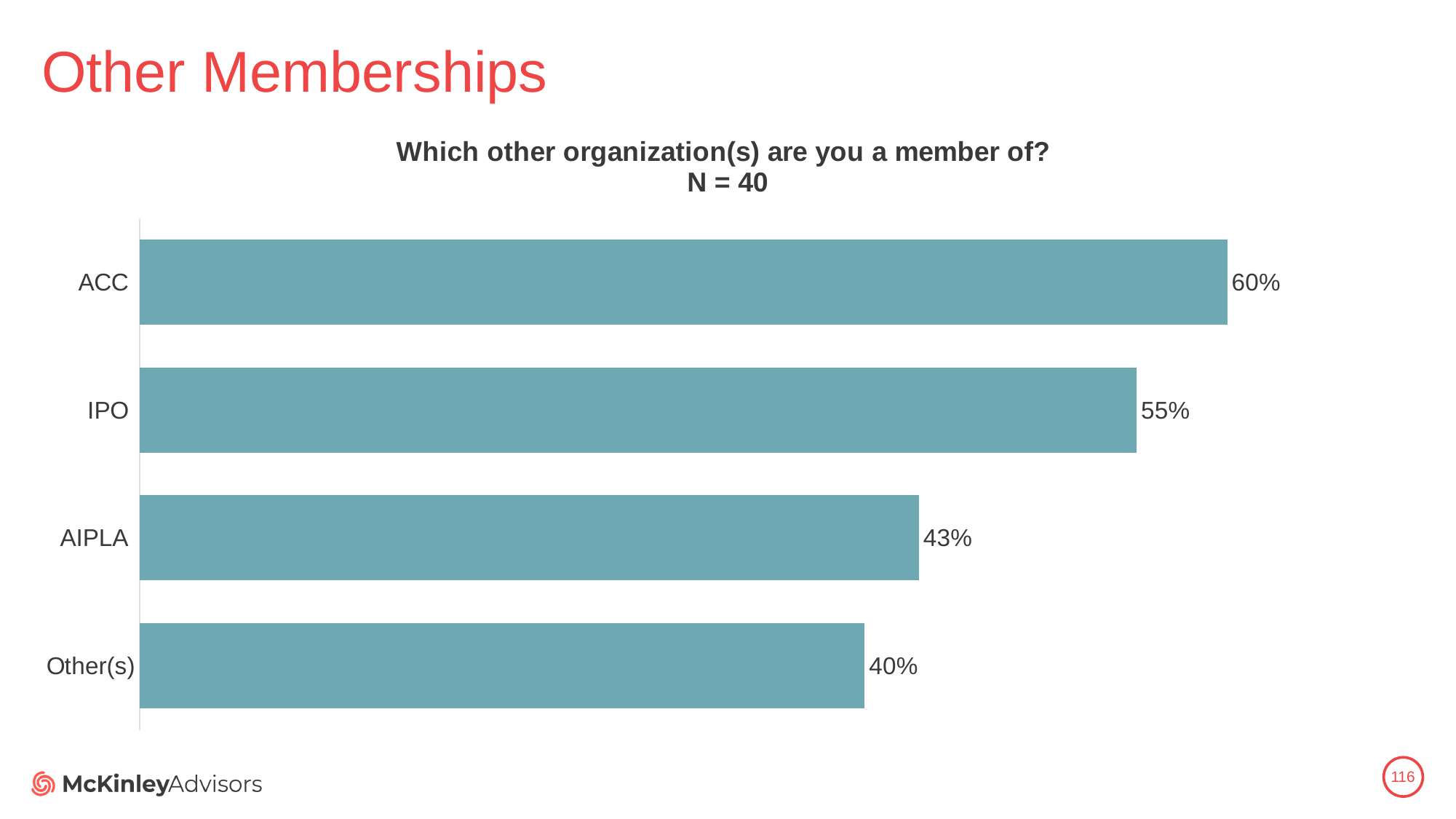
What is the sample size (N) stated in the chart title? 40 What type of chart is shown on the slide? Bar chart What is the difference in percentage points between IPO and AIPLA? 12 Which has a higher percentage, IPO or AIPLA? IPO What is the difference in percentage points between ACC and Other(s)? 20 What percentage of respondents are members of AIPLA? 43% What percentage of respondents are members of IPO? 55% How many organization categories are shown in the chart? 4 Which organization has the highest membership percentage? ACC What percentage of respondents selected Other(s)? 40% Which category has the lowest percentage? Other(s) What percentage of respondents are members of ACC? 60%